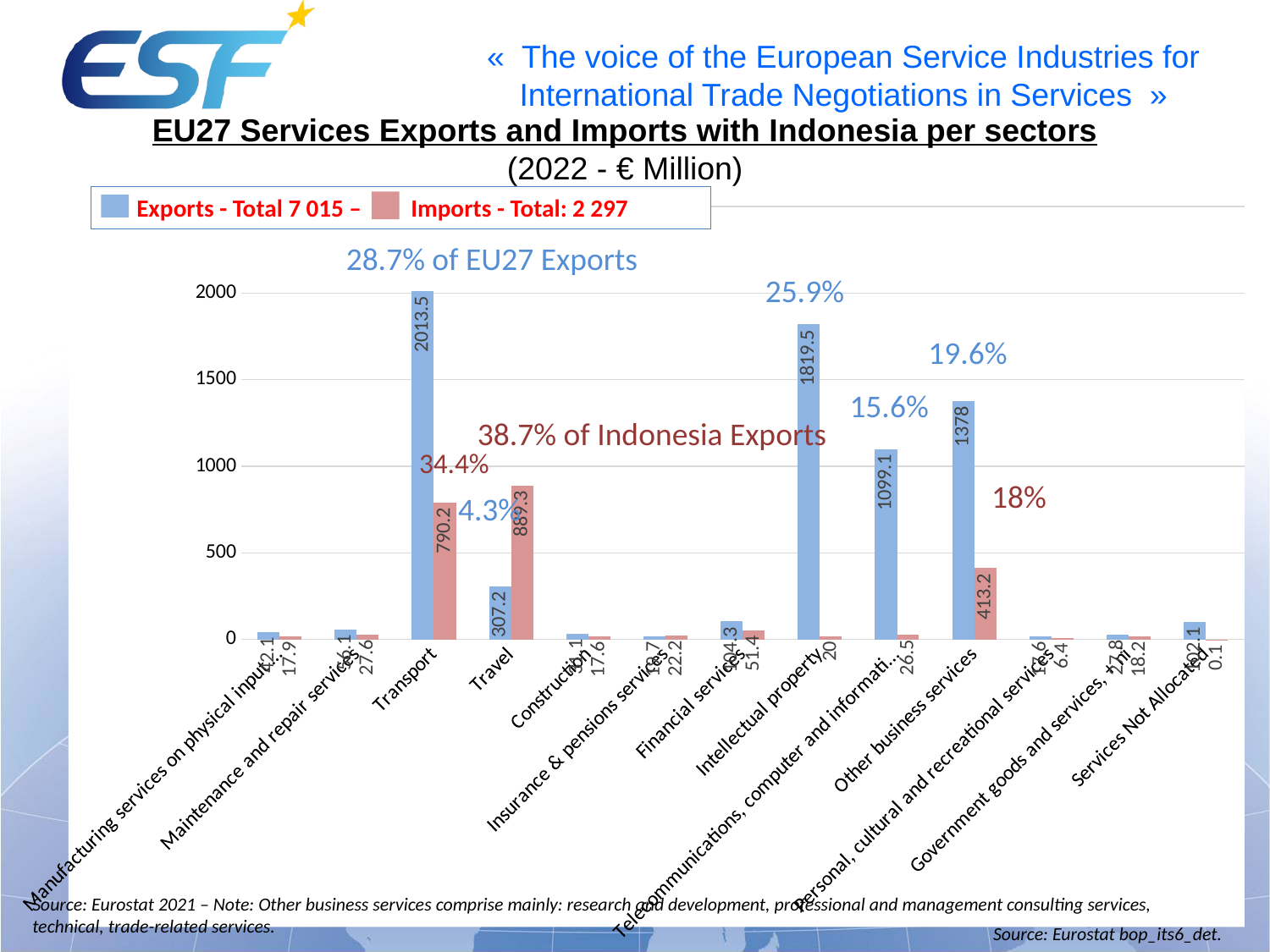
Which sector has the highest Exports value? Transport For Travel, which is larger: Exports or Imports? Imports Is the Exports value for Telecommunications, computer and information services greater or less than 1000? greater What is the difference between Exports and Imports for Transport? 1223.3 What is the difference between Exports and Imports for Other business services? 964.8 What type of chart is shown on the slide? Bar chart Which sector has the highest Imports value? Travel What is the value of Imports for Intellectual property? 20 What is the value of Exports for Transport? 2013.5 What is the value of Imports for Other business services? 413.2 How many sectors are shown on the x axis? 13 What is the value of Imports for Travel? 889.3